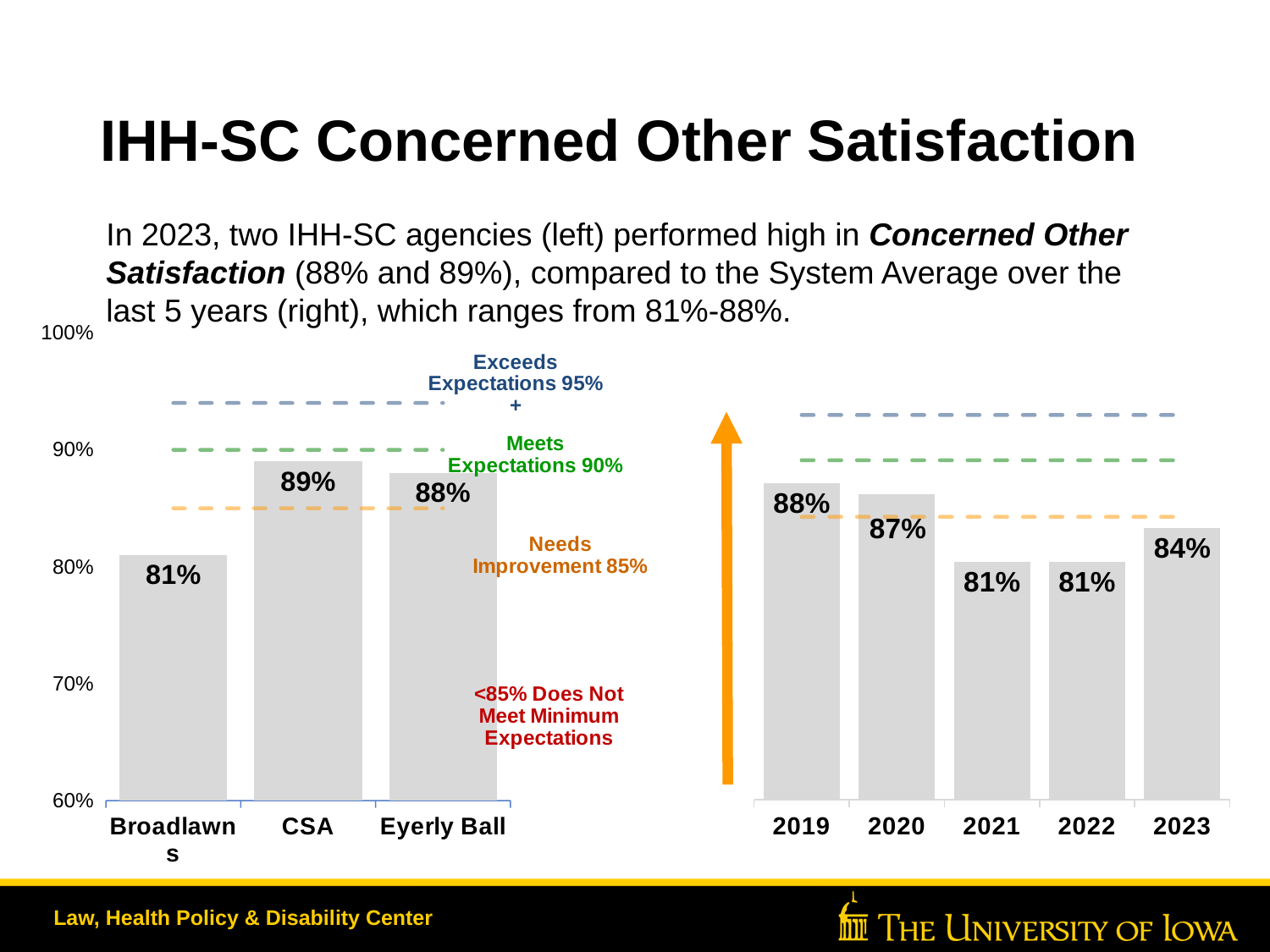
In the right chart, is the value for 2020 larger or smaller than the value for 2023? larger In the left chart, what is the difference between the values for CSA and Broadlawns? 8% In the right chart, what is the value for 2020? 87% In the left chart, what is the value for CSA? 89% In the left chart, which agency has the highest value? CSA In the right chart, what is the value for 2023? 84% In the left chart, which agency has the lowest value? Broadlawns In the left chart, what is the value for Broadlawns? 81% In the right chart, which year has the highest value? 2019 In the right chart, what is the difference between the values for 2019 and 2021? 7% What kind of chart is the right chart? bar chart In the left chart, how many agencies are shown? 3